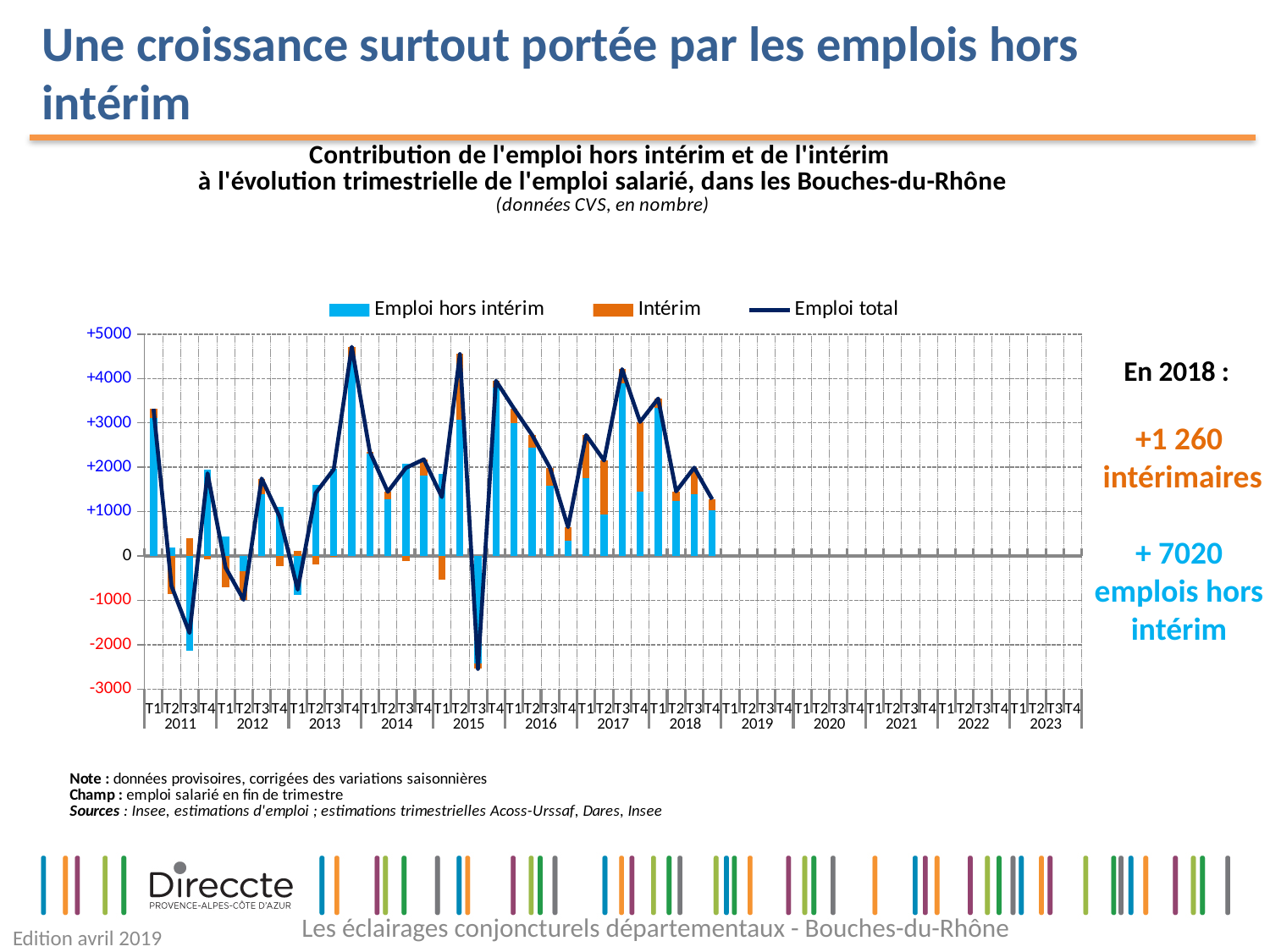
How many series does the legend list? 3 Is the value of 'Emploi total' in T4 2013 greater or less than +4000? greater According to the text beside the chart, how many 'intérimaires' were added in 2018? +1 260 How many years are labelled on the x axis? 13 Is the value of 'Emploi total' in T3 2015 greater or less than -2000? less Is the value of 'Emploi total' in T2 2015 greater or less than +4000? greater In which quarter does the 'Emploi total' line reach its lowest value? T3 2015 Which series is drawn as a line rather than bars? Emploi total What kind of chart is shown on the slide? A combination of a stacked bar chart and a line chart Which colour represents the 'Intérim' series? Orange